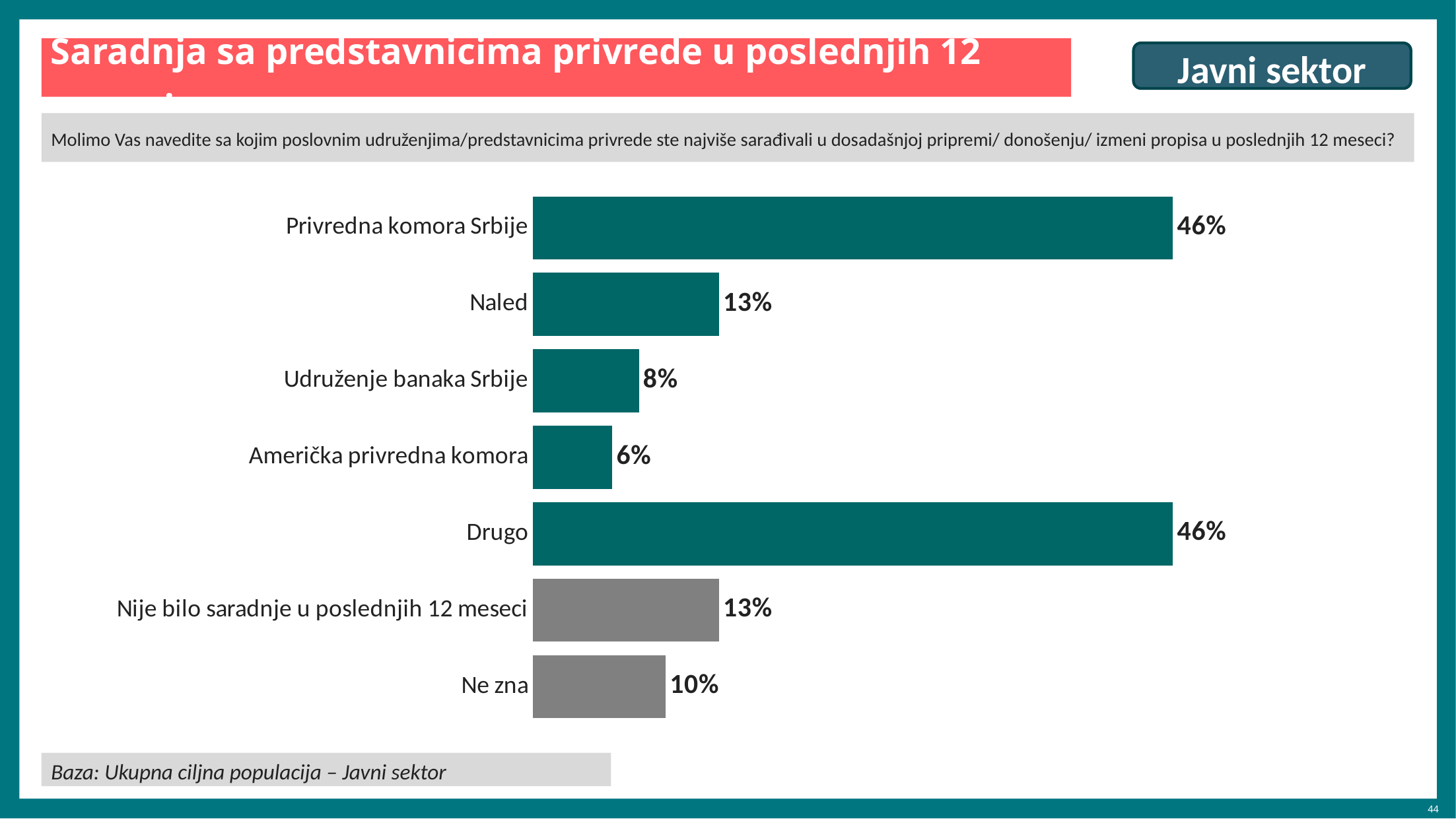
What percentage is shown for Privredna komora Srbije? 46% What is the difference between the values for Privredna komora Srbije and Naled? 33% What is the difference between the values for Ne zna and Američka privredna komora? 4% What percentage is shown for Udruženje banaka Srbije? 8% Which is larger, the value for Udruženje banaka Srbije or the value for Ne zna? Ne zna What is the value for Američka privredna komora? 6% What is the value for Naled? 13% What is the value for Nije bilo saradnje u poslednjih 12 meseci? 13% Which category has the lowest value? Američka privredna komora How many categories are shown in the chart? 7 What percentage is shown for Ne zna? 10% What kind of chart is shown on the slide? Bar chart